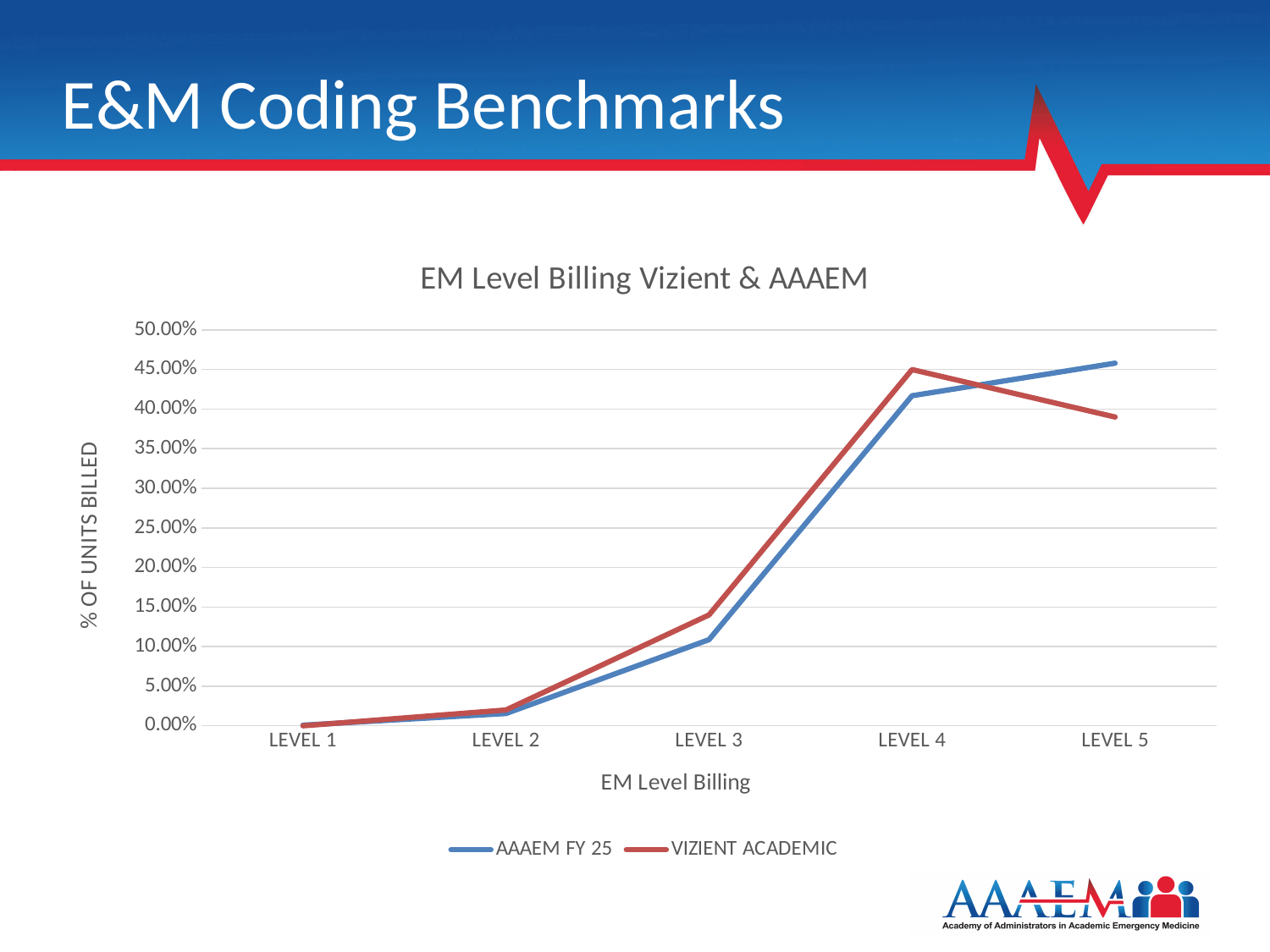
At LEVEL 4, which series has the higher value, AAAEM FY 25 or VIZIENT ACADEMIC? VIZIENT ACADEMIC Is the AAAEM FY 25 value at LEVEL 4 greater or less than 40.00%? greater At which EM level is the VIZIENT ACADEMIC series highest? LEVEL 4 What kind of chart is shown on the slide? Line chart At which EM level is the AAAEM FY 25 series lowest? LEVEL 1 What is the title of the chart? EM Level Billing Vizient & AAAEM Does the AAAEM FY 25 series rise or fall from LEVEL 1 to LEVEL 5? Rise What is the label on the vertical axis? % OF UNITS BILLED How many series does the legend list? 2 How many EM levels are plotted along the x axis? 5 At LEVEL 5, which series has the higher value, AAAEM FY 25 or VIZIENT ACADEMIC? AAAEM FY 25 At which EM level is the AAAEM FY 25 series highest? LEVEL 5